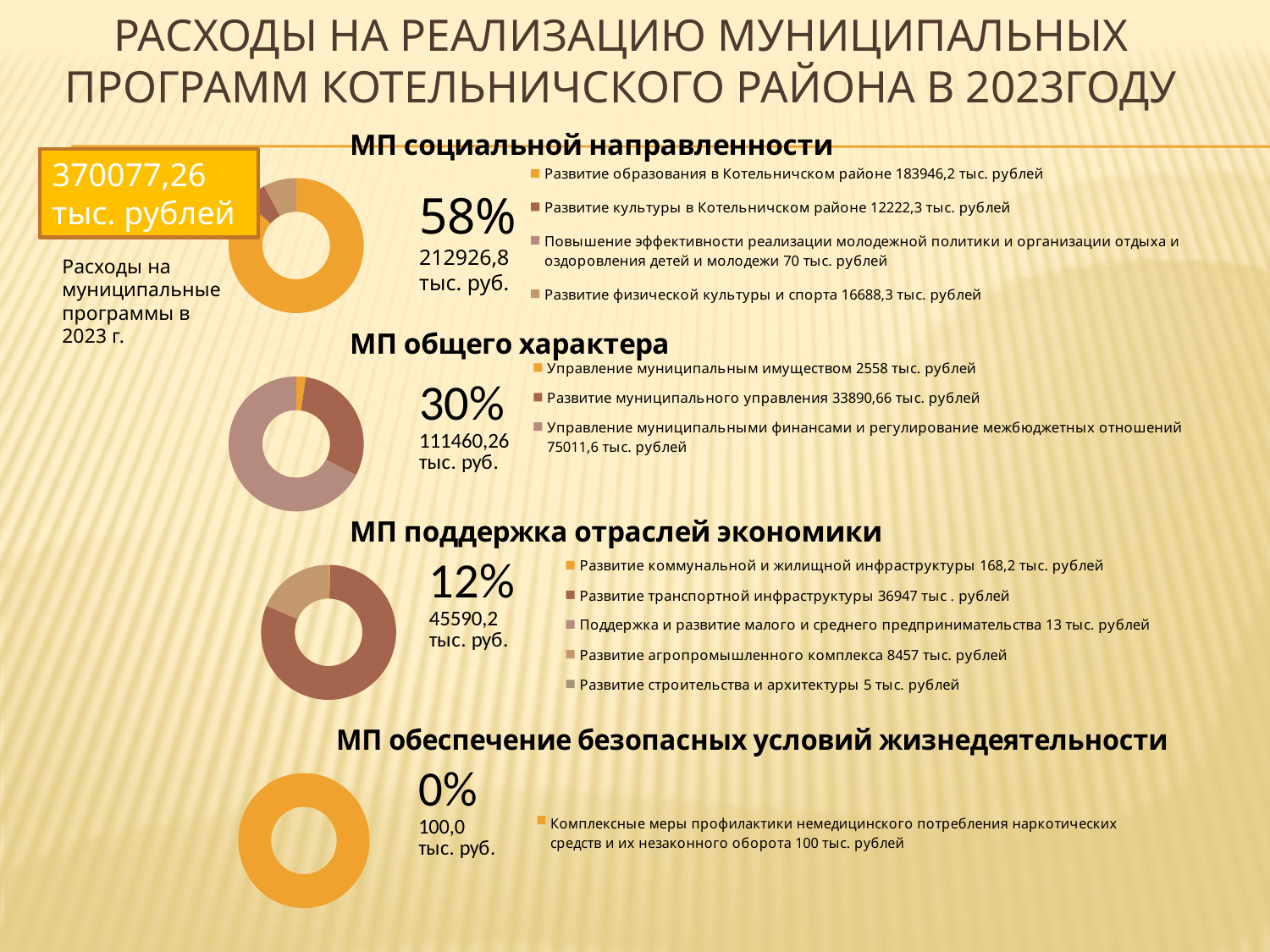
On the 'МП социальной направленности' chart, which legend entry has the smallest value? Повышение эффективности реализации молодежной политики и организации отдыха и оздоровления детей и молодежи On the 'МП поддержка отраслей экономики' chart, which is larger: 'Развитие агропромышленного комплекса' or 'Развитие коммунальной и жилищной инфраструктуры'? Развитие агропромышленного комплекса On the 'МП общего характера' chart, which legend entry has the largest value? Управление муниципальными финансами и регулирование межбюджетных отношений On the 'МП общего характера' chart, what is the value for 'Развитие муниципального управления'? 33890,66 тыс. рублей On the 'МП социальной направленности' chart, what is the difference between 'Развитие образования в Котельничском районе' and 'Развитие культуры в Котельничском районе'? 171723,9 тыс. рублей On the 'МП поддержка отраслей экономики' chart, what is the value for 'Развитие транспортной инфраструктуры'? 36947 тыс. рублей On the 'МП социальной направленности' chart, what is the value for 'Развитие образования в Котельничском районе'? 183946,2 тыс. рублей On the 'МП поддержка отраслей экономики' chart, how many entries does the legend list? 5 On the 'МП обеспечение безопасных условий жизнедеятельности' chart, what total amount is shown next to the chart? 100,0 тыс. руб. On the 'МП общего характера' chart, what percentage share of total programme spending is shown next to the chart? 30% On the 'МП социальной направленности' chart, how many entries does the legend list? 4 What type of chart is used for 'МП социальной направленности'? Doughnut chart